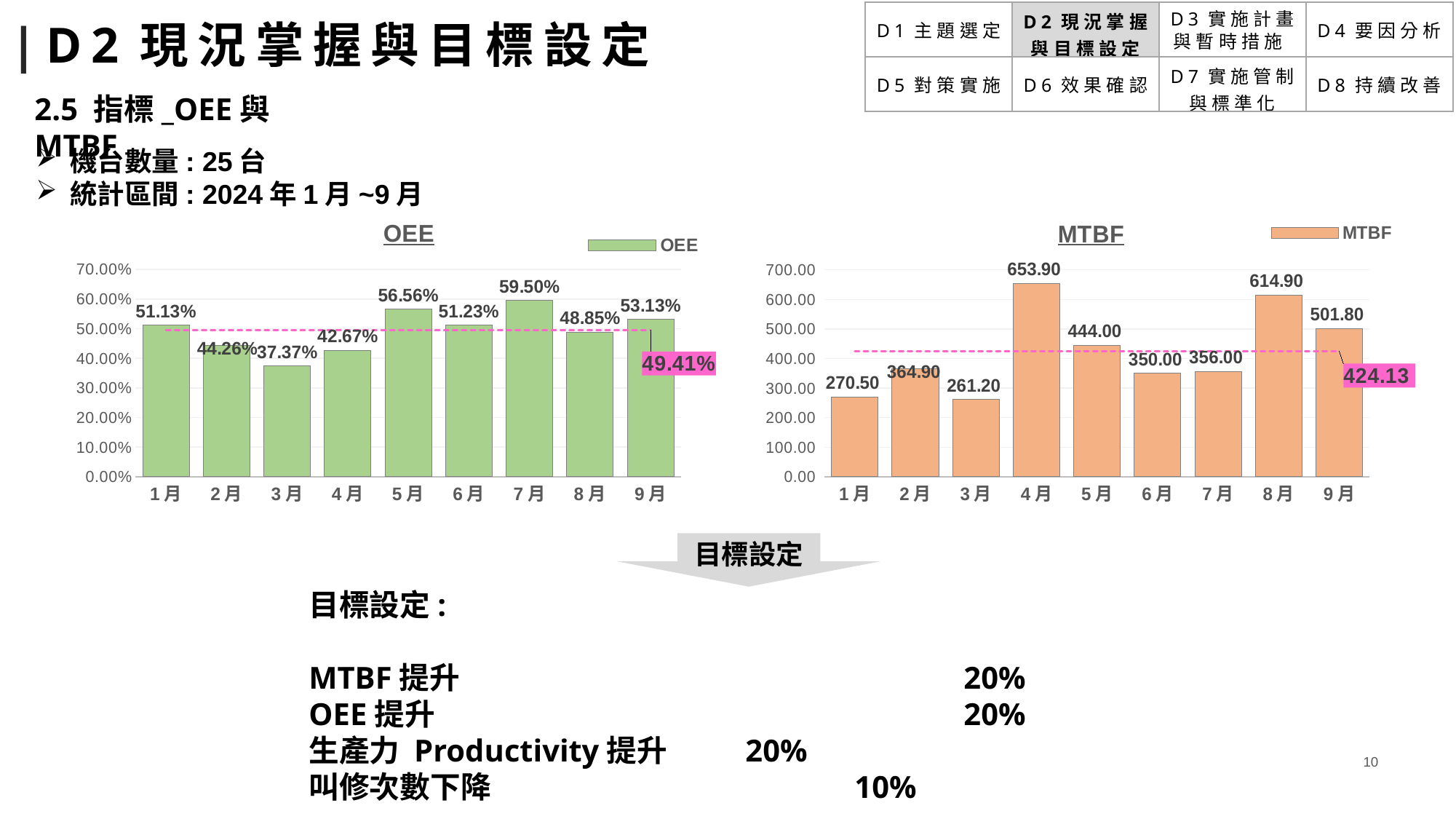
In the OEE chart, what is the difference between the values for 7月 and 3月? 22.13% In the OEE chart, what value is shown in the highlighted label for the dashed average line? 49.41% In the OEE chart, how many months are plotted on the x axis? 9 What kind of chart is the MTBF chart? Bar chart In the MTBF chart, is the value for 8月 larger than the value for 9月? Yes, 8月 In the MTBF chart, which month has the highest value? 4月 In the MTBF chart, what value is shown in the highlighted label for the dashed average line? 424.13 In the MTBF chart, which month has the lowest value? 3月 In the MTBF chart, what is the difference between the values for 8月 and 9月? 113.10 In the OEE chart, what is the value for 7月? 59.50% In the OEE chart, which month has the lowest value? 3月 In the MTBF chart, what is the value for 4月? 653.90